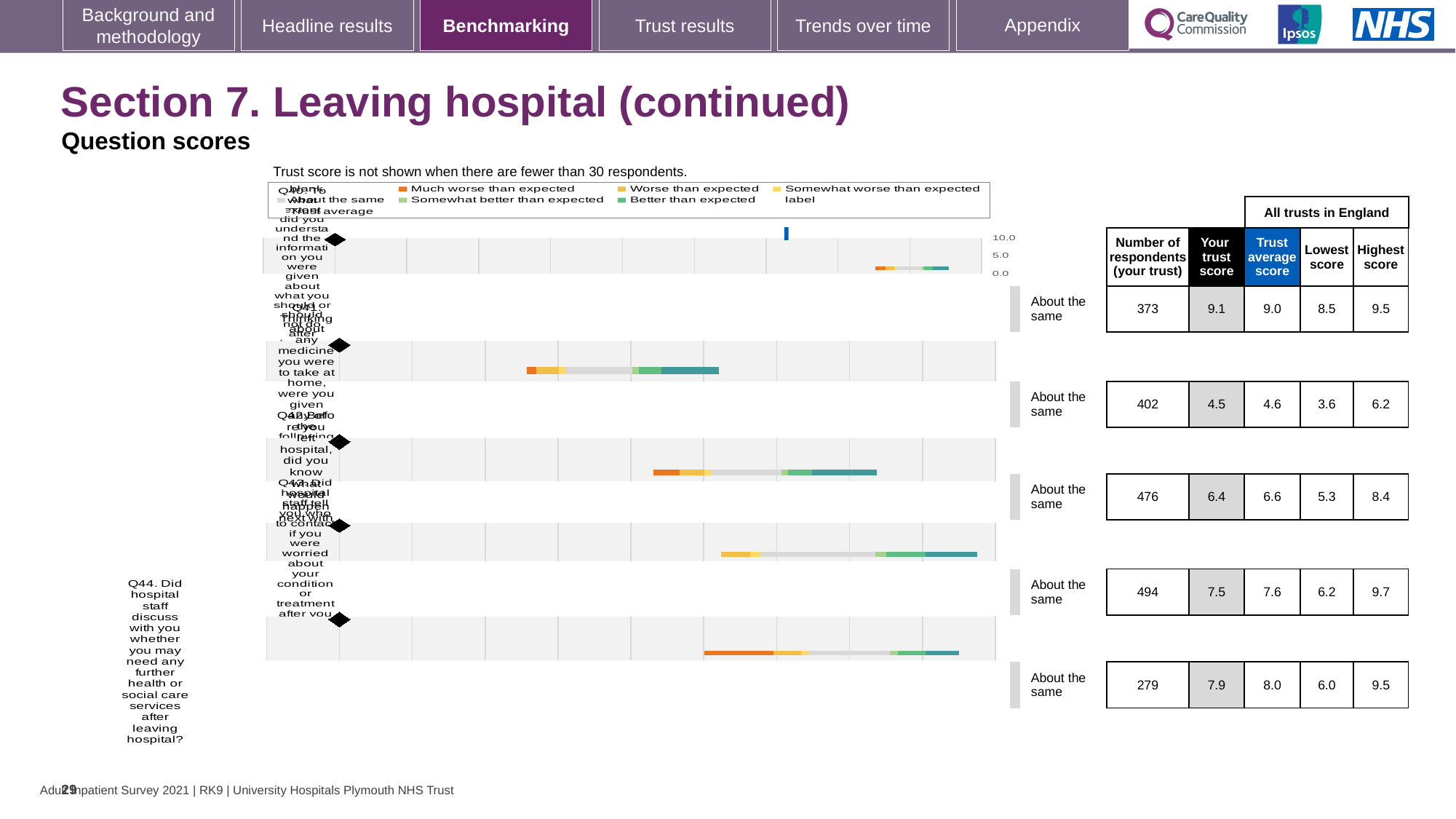
What is the highest score across all trusts in England for Q44 (the bottom row)? 9.5 In the table, how many respondents are shown for Q44 (the bottom row)? 279 How many question rows are shown in the chart and table? 5 What benchmark category label is shown next to every question row? About the same What is the largest number of respondents shown in the table? 494 What is the 'Your trust score' value for Q44 (the bottom row of the table)? 7.9 What kind of chart is used to show the question scores? Bar chart What is the smallest number of respondents shown in the table? 279 What is the trust average score shown in the first row of the table? 9.0 For Q44 (the bottom row), by how much does the trust average score exceed your trust score? 0.1 For Q44 (the bottom row), which is larger: your trust score or the trust average score? Trust average score (8.0) For Q44 (the bottom row), what is the difference between the highest score (9.5) and the lowest score (6.0)? 3.5